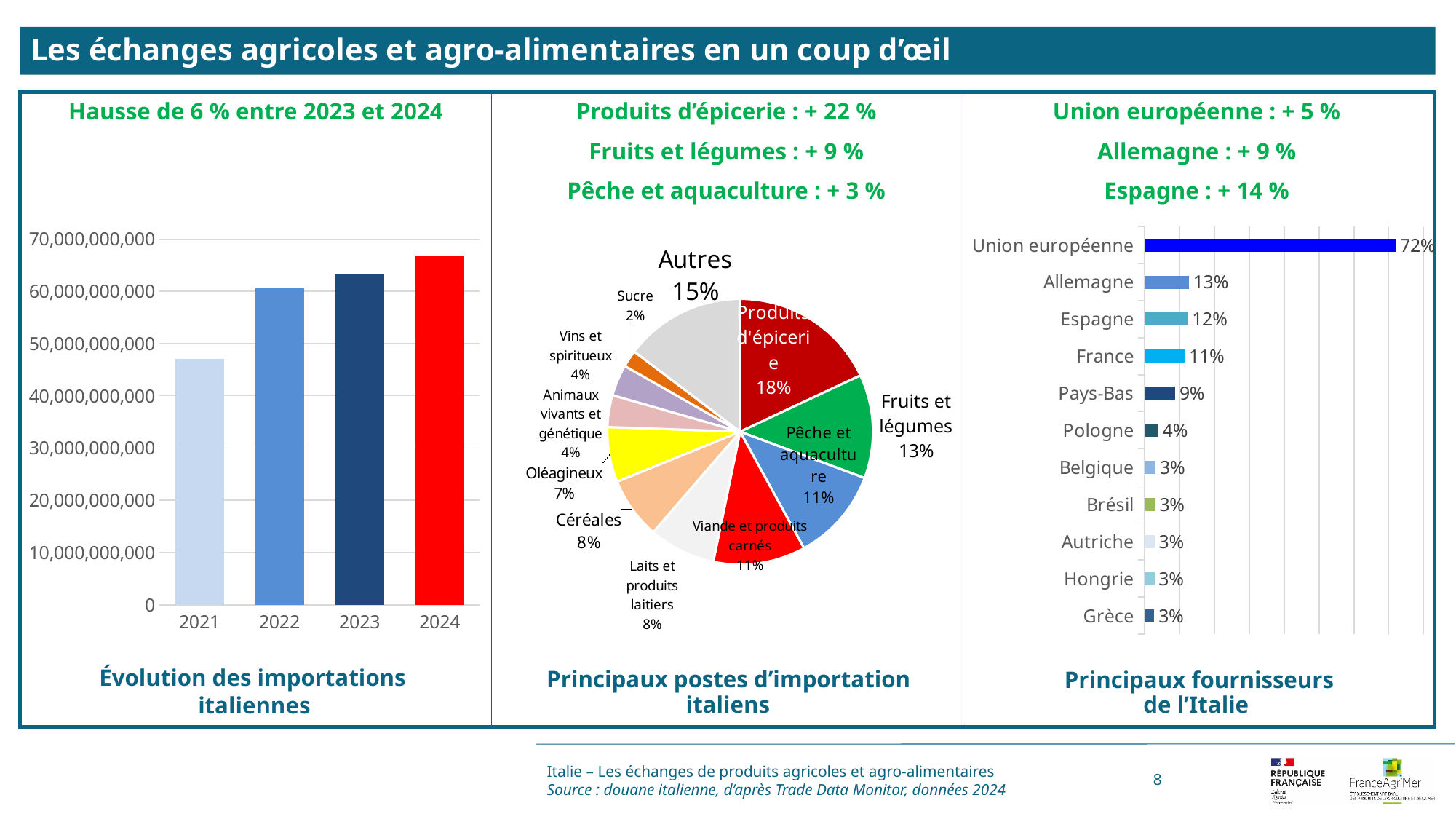
In the chart 'Évolution des importations italiennes', which year has the highest bar? 2024 In the chart 'Évolution des importations italiennes', is the value for 2021 greater or less than 50,000,000,000? less In the pie chart 'Principaux postes d'importation italiens', what share does 'Produits d'épicerie' have? 18% In the chart 'Principaux fournisseurs de l'Italie', how many categories are shown? 11 In the chart 'Évolution des importations italiennes', which year has the lowest bar? 2021 In the chart 'Évolution des importations italiennes', do the values rise or fall from 2021 to 2024? rise In the chart 'Évolution des importations italiennes', is the value for 2024 greater or less than 60,000,000,000? greater In the pie chart 'Principaux postes d'importation italiens', which named category has the smallest slice? Sucre What kind of chart is 'Principaux postes d'importation italiens'? pie chart In the chart 'Principaux fournisseurs de l'Italie', which is larger, the value for Allemagne or the value for France? Allemagne In the chart 'Principaux fournisseurs de l'Italie', what is the value for Pays-Bas? 9% In the pie chart 'Principaux postes d'importation italiens', what is the difference in percentage points between 'Produits d'épicerie' and 'Fruits et légumes'? 5 percentage points